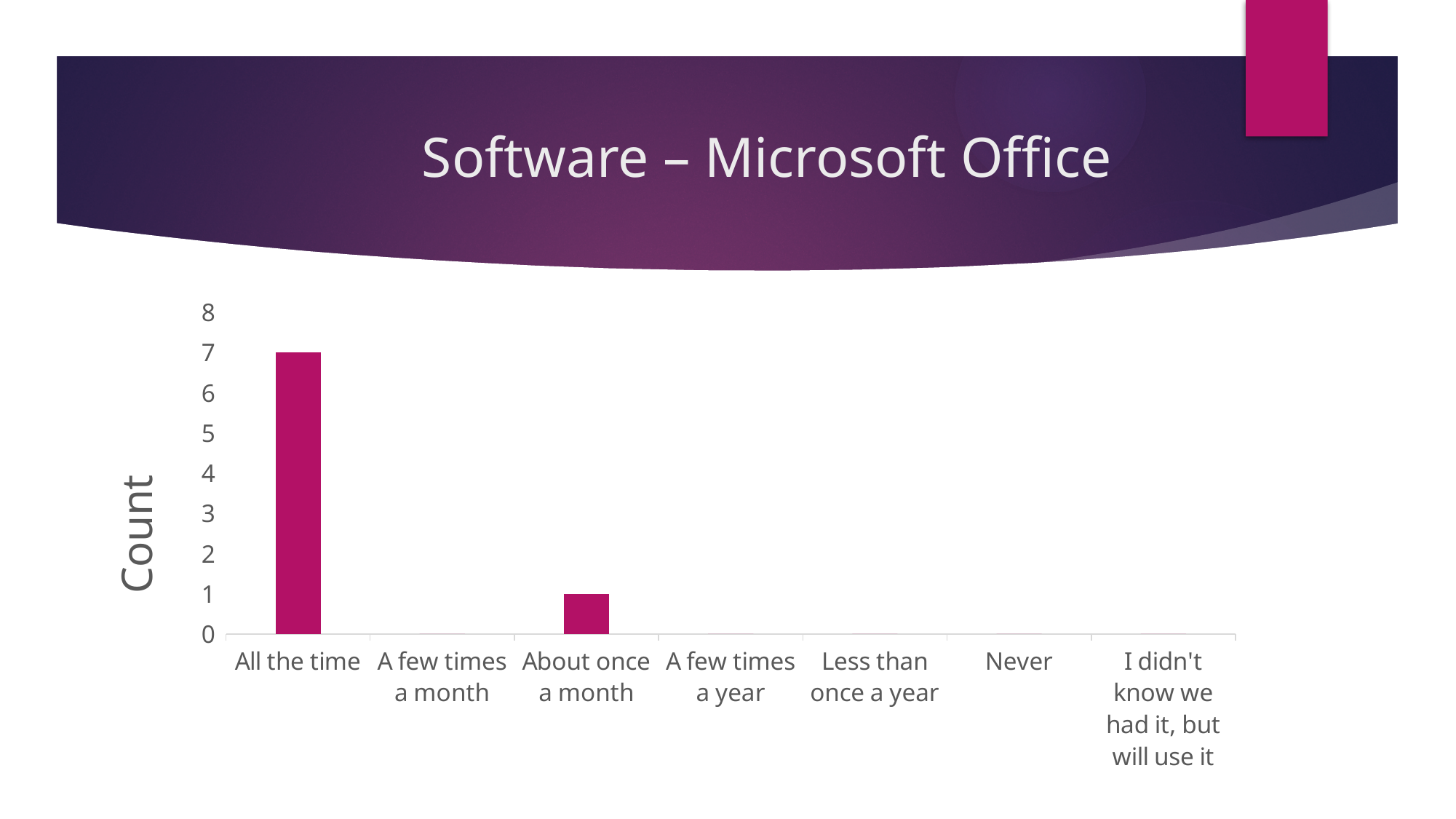
Which category has the highest count? All the time What is the title of the slide? Software – Microsoft Office How many categories are shown on the x axis? 7 What is the highest value shown on the vertical axis? 8 Is the count for "All the time" greater or less than 5? greater What is the difference between the counts for "All the time" and "About once a month"? 6 Which is larger, the count for "All the time" or the count for "About once a month"? All the time What is the label of the vertical axis? Count What is the count for "About once a month"? 1 What is the count for "Never"? 0 What kind of chart is shown on the slide? bar chart What is the count for "All the time"? 7